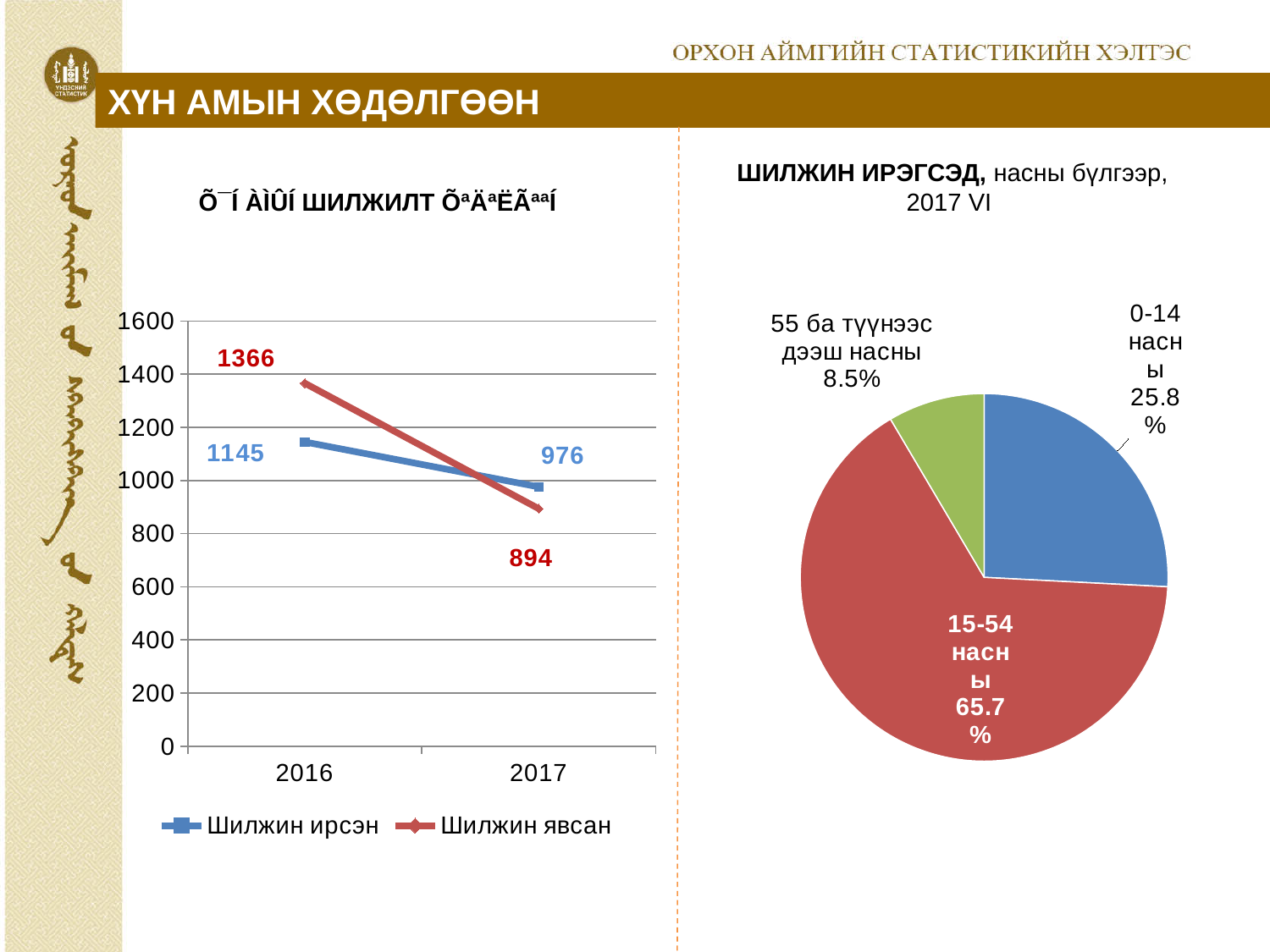
On the line chart on the left, what is the value for Шилжин явсан in 2017? 894 On the line chart on the left, how many series does the legend list? 2 In the pie chart titled 'ШИЛЖИН ИРЭГСЭД, насны бүлгээр, 2017 VI', what share does the 15-54 насны group have? 65.7% On the line chart on the left, by how much did Шилжин ирсэн decrease from 2016 to 2017? 169 On the line chart on the left, which series has the larger value in 2017, Шилжин ирсэн or Шилжин явсан? Шилжин ирсэн On the line chart on the left, what is the value for Шилжин явсан in 2016? 1366 In the pie chart titled 'ШИЛЖИН ИРЭГСЭД, насны бүлгээр, 2017 VI', how many slices are there? 3 On the line chart on the left, does the value for Шилжин явсан rise or fall from 2016 to 2017? fall On the line chart on the left, what is the value for Шилжин ирсэн in 2016? 1145 On the line chart on the left, what is the difference between Шилжин явсан and Шилжин ирсэн in 2016? 221 In the pie chart titled 'ШИЛЖИН ИРЭГСЭД, насны бүлгээр, 2017 VI', which age group has the smallest share? 55 ба түүнээс дээш насны What type of chart is shown on the right side of the slide? pie chart